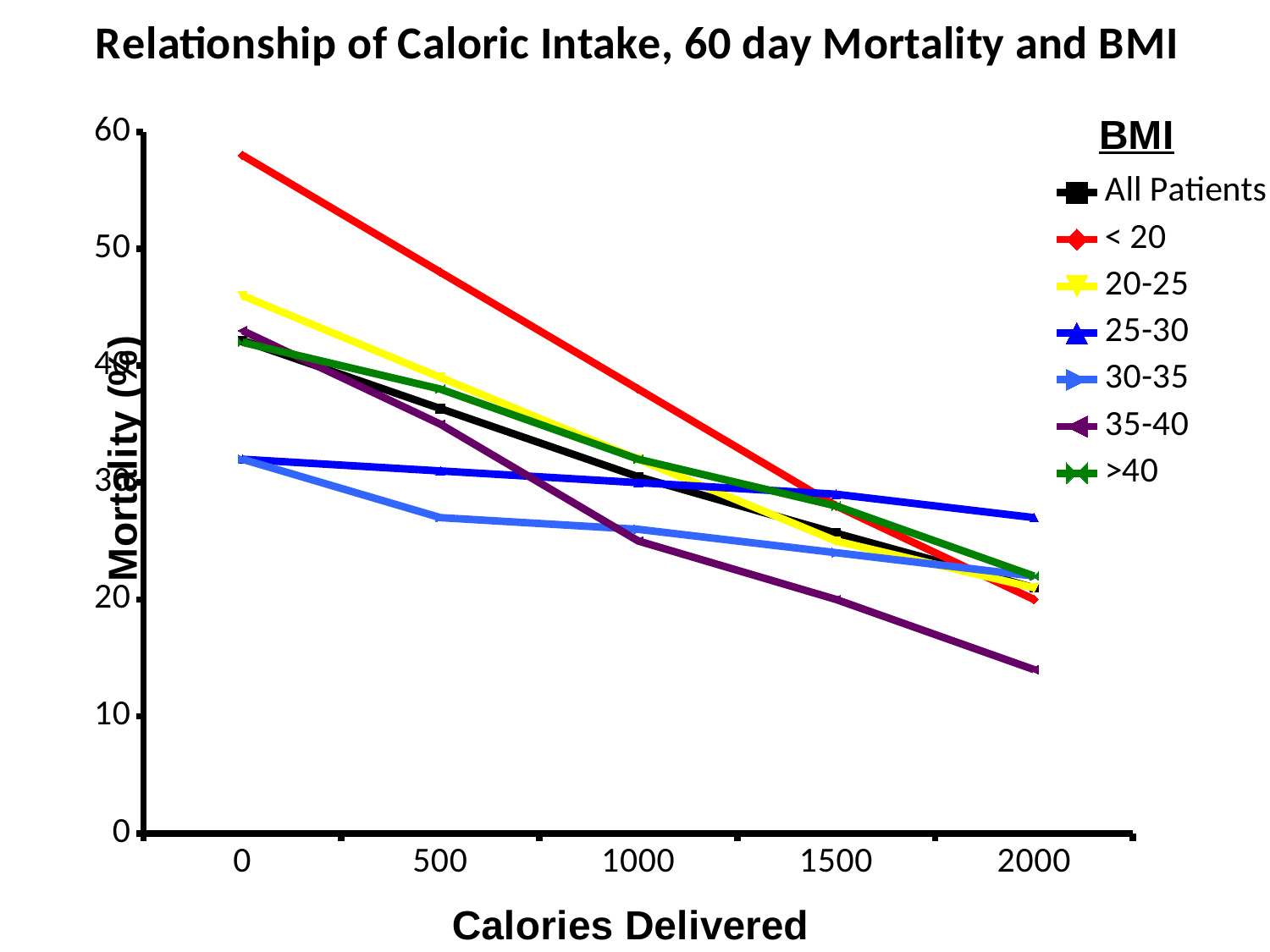
Which BMI group has the highest mortality at 0 calories delivered? < 20 Is the mortality for the 35-40 BMI group at 2000 calories delivered greater or less than 20? less Is the mortality for the 20-25 BMI group at 0 calories delivered greater or less than 40? greater Is the mortality for the 30-35 BMI group at 1000 calories delivered greater or less than 30? less How many series does the legend list? 7 Which BMI group has the lowest mortality at 2000 calories delivered? 35-40 Does mortality for the < 20 BMI group rise or fall as calories delivered increase? Fall At 2000 calories delivered, which has higher mortality: the 25-30 BMI group or the 35-40 BMI group? 25-30 How many calorie levels are marked on the x axis? 5 What is the label of the x axis? Calories Delivered What kind of chart is shown on the slide? Line chart